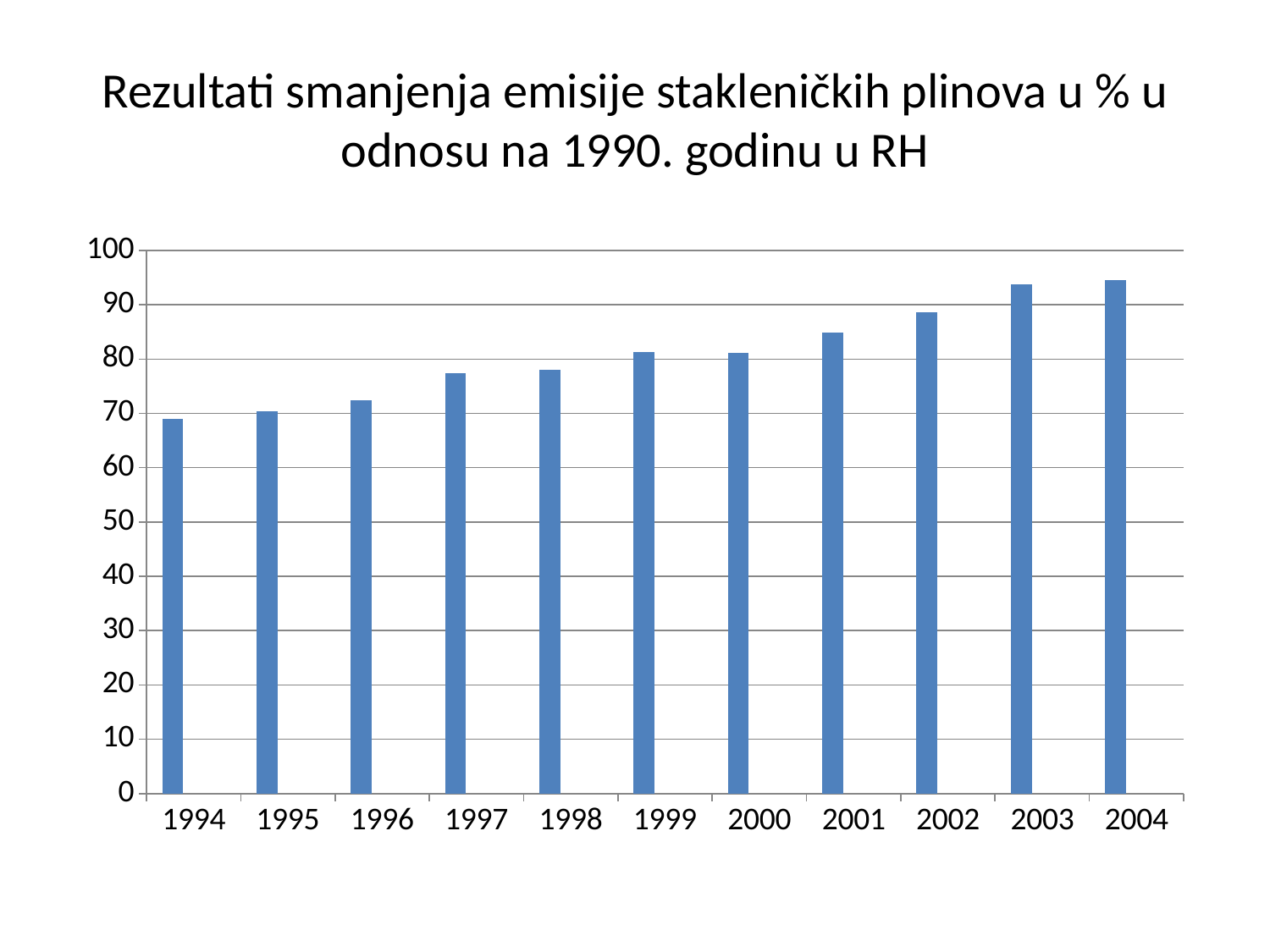
What kind of chart is shown on the slide? bar chart Is the value for 1997 greater or less than 70? greater Which year has the larger value, 1994 or 2004? 2004 What is the title of the chart on the slide? Rezultati smanjenja emisije stakleničkih plinova u % u odnosu na 1990. godinu u RH Is the value for 1996 greater or less than 80? less Is the value for 1995 greater or less than 60? greater Do the values generally rise or fall from 1994 to 2004? rise Which year has the larger value, 1997 or 2002? 2002 How many years are shown on the x axis of the chart? 11